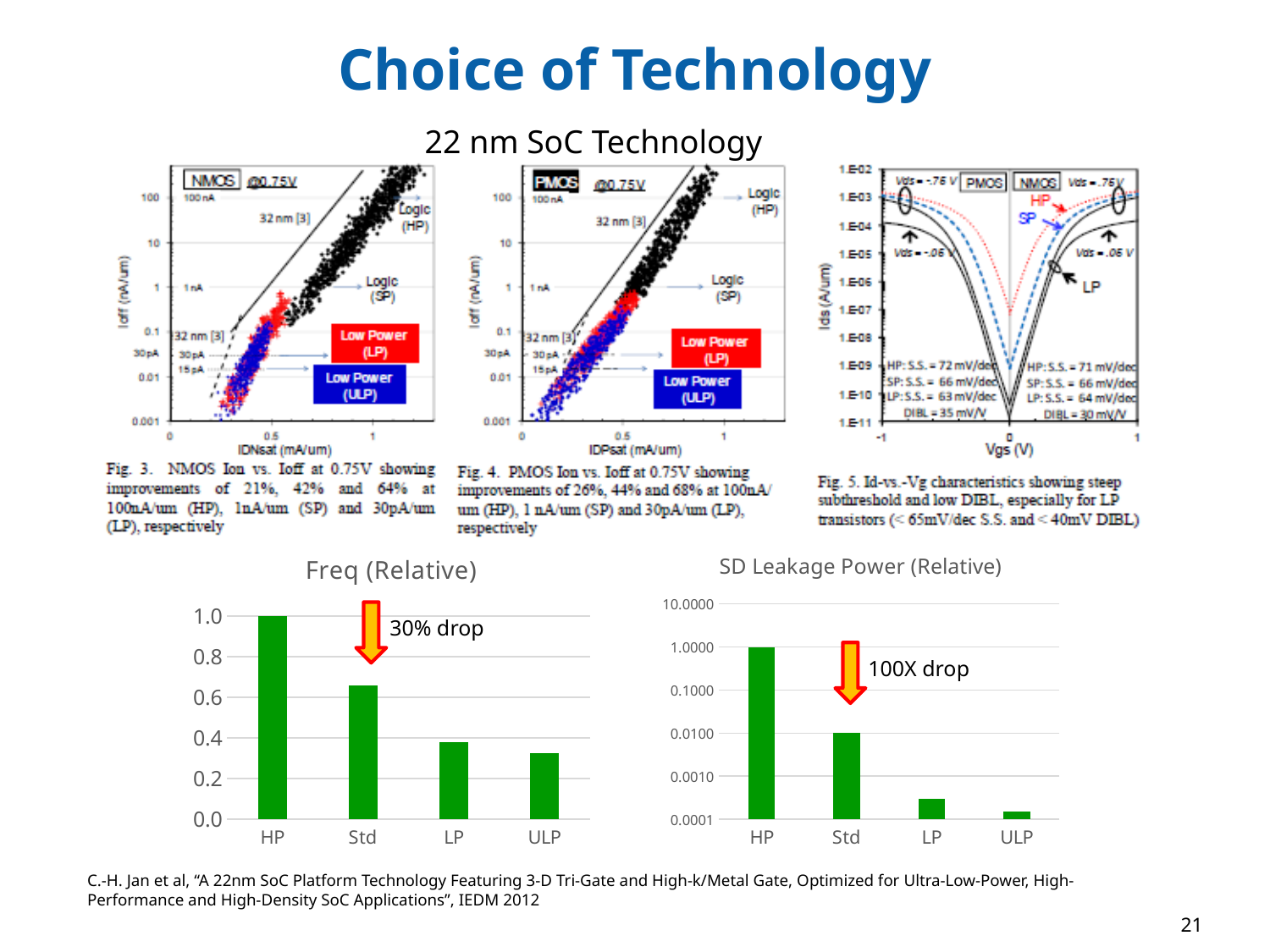
In the 'SD Leakage Power (Relative)' chart, is the value for LP greater or less than 0.0010? less What drop does the annotation on the 'SD Leakage Power (Relative)' chart indicate between HP and Std? 100X drop In the 'SD Leakage Power (Relative)' chart, what is the value for Std? 0.0100 In the 'Freq (Relative)' chart, is the value for Std greater or less than 0.6? greater What kind of chart is the 'Freq (Relative)' chart? bar chart How many categories are shown on the x axis of the 'Freq (Relative)' chart? 4 In the 'Freq (Relative)' chart, which category has the lowest value? ULP In the 'Freq (Relative)' chart, which category has the highest value? HP In the 'Freq (Relative)' chart, what is the value for HP? 1.0 In the 'SD Leakage Power (Relative)' chart, what is the value for HP? 1.0000 In the 'Freq (Relative)' chart, do the values rise or fall from HP to ULP along the x axis? fall